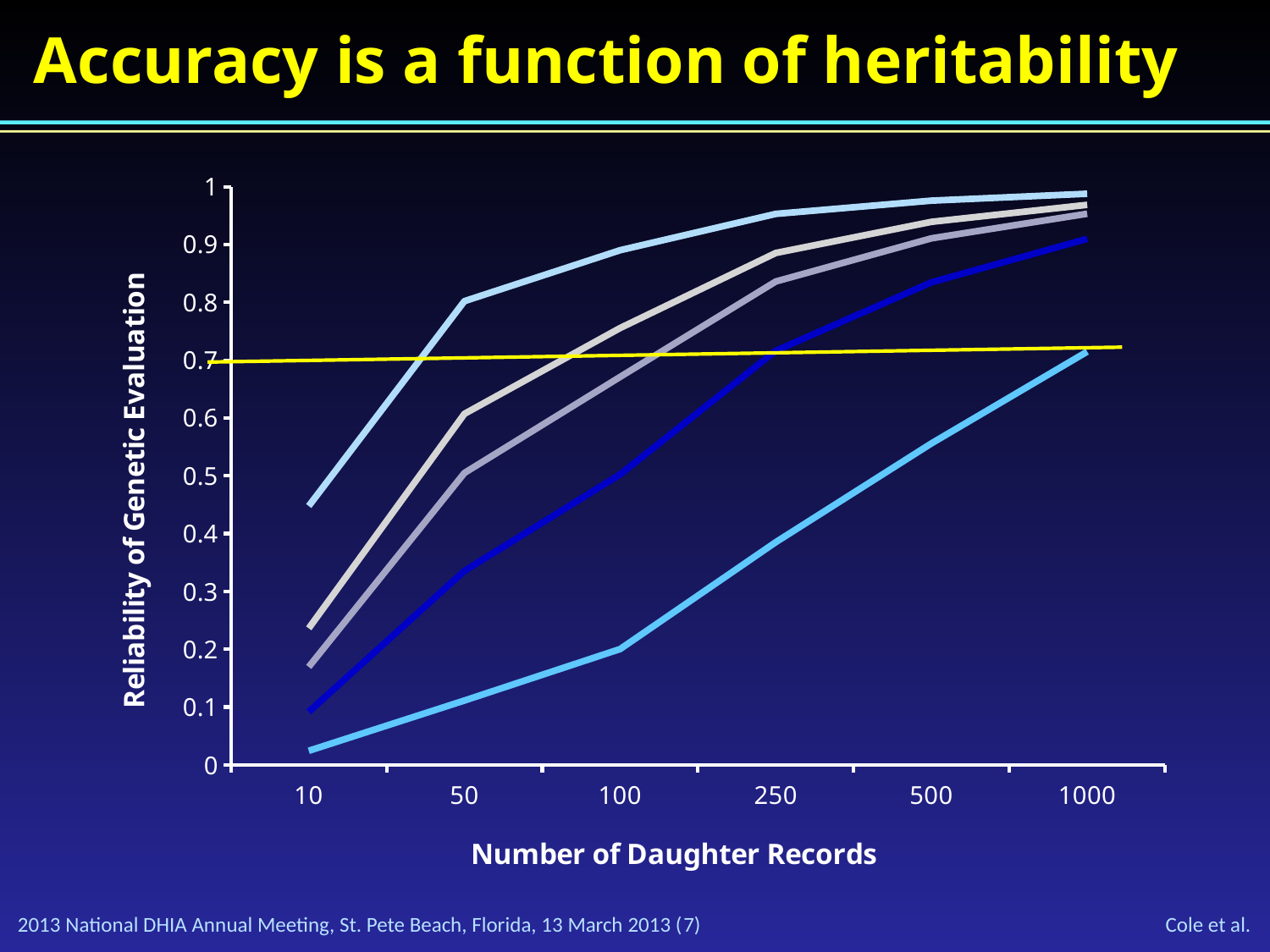
At which number of daughter records is the reliability of the lowest line smallest? 10 What kind of chart is shown on the slide? line chart What is the title of the slide's chart? Accuracy is a function of heritability Is the value of the topmost line at 1000 daughter records greater or less than 0.9? greater Is the value of the lowest line at 1000 daughter records greater or less than 0.6? greater What is the label of the y axis? Reliability of Genetic Evaluation At which number of daughter records does the topmost line reach its highest reliability? 1000 How many categories are shown on the x axis? 6 Is the value of the lowest line at 100 daughter records greater or less than 0.3? less Do the plotted lines rise or fall as the number of daughter records increases? rise